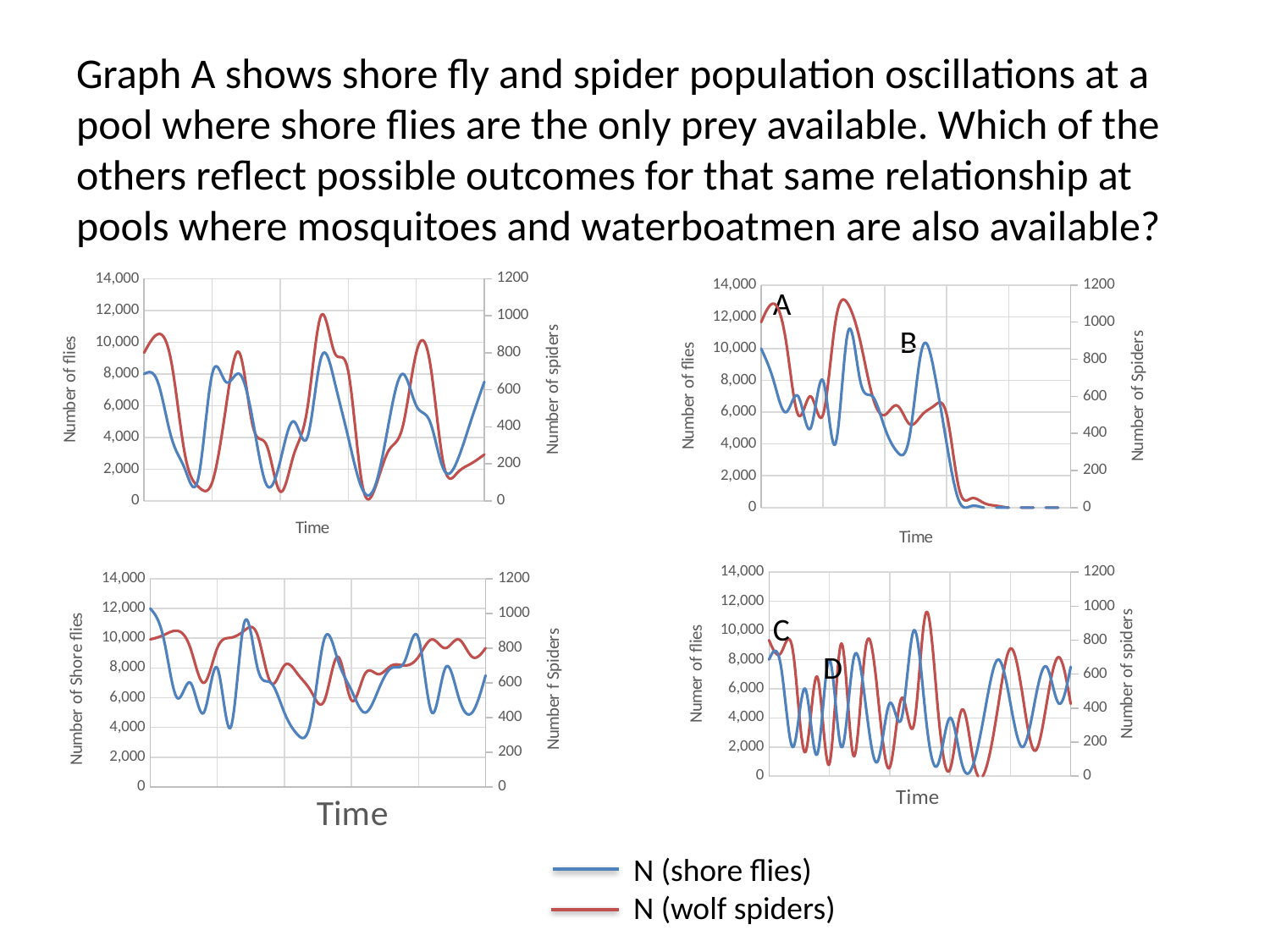
In the top-left chart, is the highest value reached by the N (shore flies) series greater or less than 8,000? greater In the top-right chart, is the final value of the N (shore flies) series greater or less than 2,000? less Which series is drawn in red according to the legend? N (wolf spiders) In the bottom-right chart, is the highest value reached by the N (wolf spiders) series greater or less than 800 on the right axis? greater What is the maximum tick value on the left vertical axis of the bottom-right chart? 14,000 In the top-right chart, do the N (shore flies) values overall rise or fall along the Time axis? fall What kind of chart is the top-left chart on the slide? line chart What is the label on the left vertical axis of the bottom-left chart? Number of Shore flies How many charts are shown on the slide? 4 How many series does the legend at the bottom of the slide list? 2